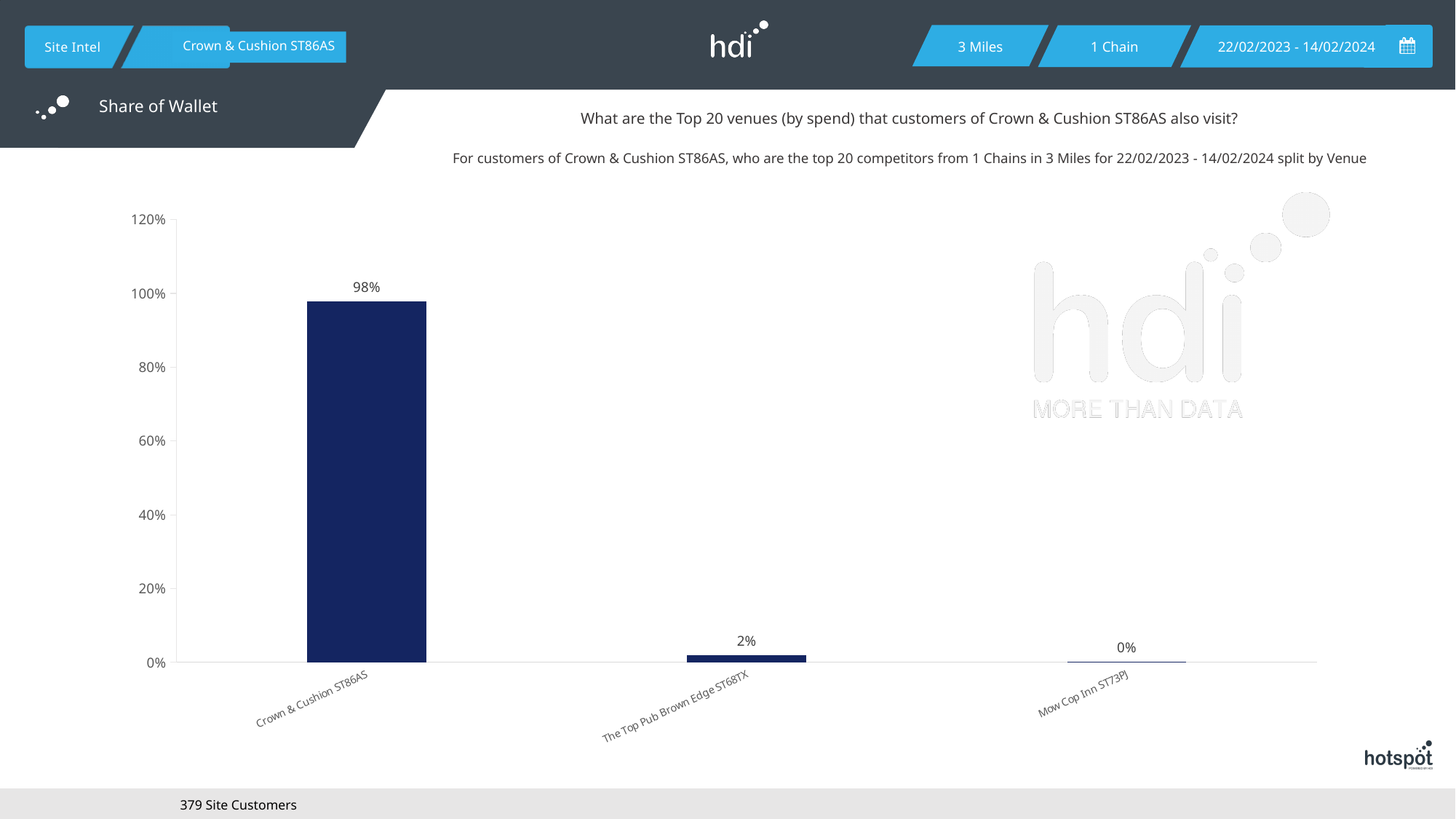
What is the value for Mow Cop Inn ST73PJ? 0% Which is larger, the value for The Top Pub Brown Edge ST68TX or the value for Mow Cop Inn ST73PJ? The Top Pub Brown Edge ST68TX Which venue has the highest value? Crown & Cushion ST86AS What is the highest value shown on the vertical axis? 120% What is the value for The Top Pub Brown Edge ST68TX? 2% Is the value for Crown & Cushion ST86AS greater or less than 80%? greater What is the value for Crown & Cushion ST86AS? 98% How many venues are shown on the chart? 3 Which venue has the lowest value? Mow Cop Inn ST73PJ What kind of chart is shown on the slide? bar chart What is the difference between the values for Crown & Cushion ST86AS and The Top Pub Brown Edge ST68TX? 96% Do the values rise or fall from left to right along the x axis? fall